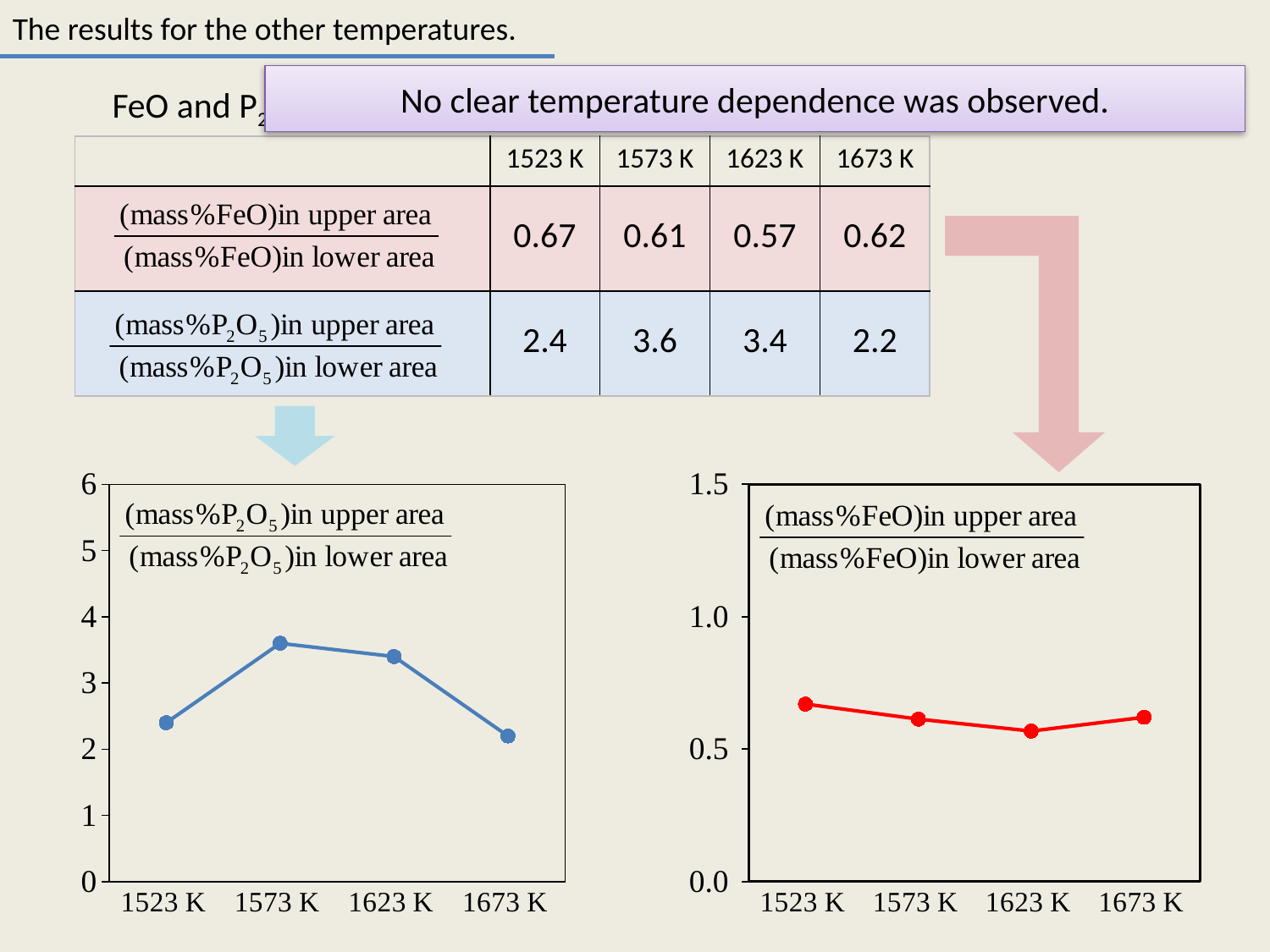
In the right chart (FeO ratio), what is the value at 1523 K? 0.67 In the right chart (FeO ratio), which temperature has the highest value? 1523 K In the right chart (FeO ratio), is the value at 1623 K greater or less than 1.0? less In the left chart (P2O5 ratio), what is the difference between the values at 1573 K and 1673 K? 1.4 What type of chart is the left chart showing the P2O5 ratio? line chart In the left chart (P2O5 ratio), is the value at 1523 K greater or less than 3? less In the left chart (P2O5 ratio), which temperature has the lowest value? 1673 K What colour is the line in the right chart (FeO ratio)? red In the left chart (P2O5 ratio), what is the value at 1573 K? 3.6 How many temperature points are plotted in the right chart (FeO ratio)? 4 In the right chart (FeO ratio), which temperature has the lowest value? 1623 K In the left chart (P2O5 ratio), which temperature has the highest value? 1573 K